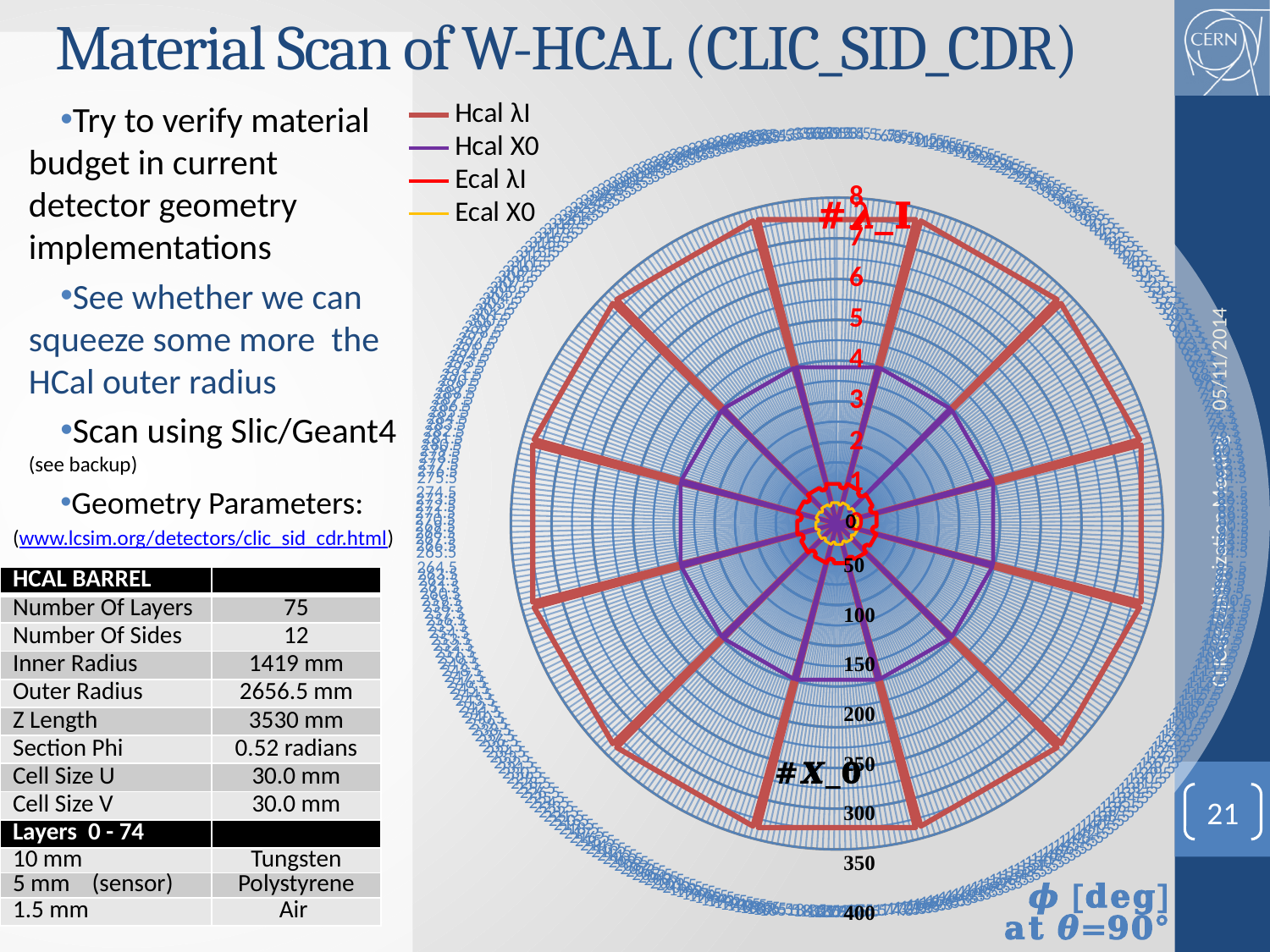
Which series has larger values, Hcal λI or Ecal λI? Hcal λI Which series extends farthest from the centre of the chart? Hcal λI Which series are listed in the chart legend? Hcal λI, Hcal X0, Ecal λI, Ecal X0 Is the value of Hcal λI greater or less than 6 on the λI scale? greater What is the highest tick label shown on the X0 radial axis? 400 How many series does the chart legend list? 4 Which series has larger values, Hcal X0 or Ecal X0? Hcal X0 What kind of chart is shown on the slide? radar chart How many sides does the Hcal λI polygon on the chart have? 12 What colour is the Hcal X0 series drawn in? purple Which series stays closest to the centre of the chart? Ecal X0